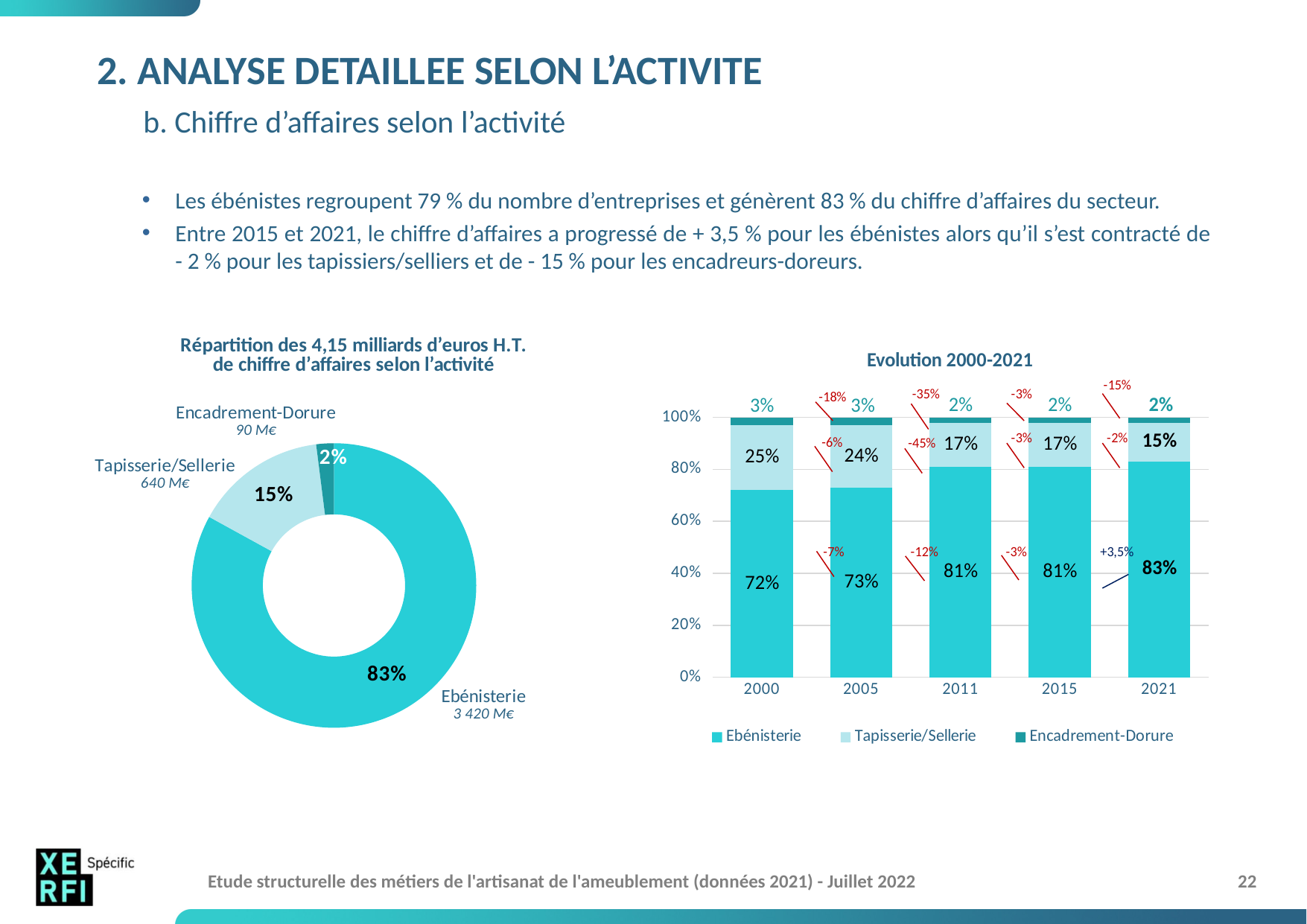
In the 'Evolution 2000-2021' chart, what is the value for Tapisserie/Sellerie in 2011? 17% How many series does the legend of the 'Evolution 2000-2021' chart list? 3 In the 'Répartition des 4,15 milliards d'euros H.T. de chiffre d'affaires selon l'activité' chart, which activity has the smallest share? Encadrement-Dorure In the 'Evolution 2000-2021' chart, does the Tapisserie/Sellerie share rise or fall from 2000 to 2021? Fall In the 'Répartition des 4,15 milliards d'euros H.T. de chiffre d'affaires selon l'activité' chart, what value in M€ is shown for Tapisserie/Sellerie? 640 M€ In the 'Répartition des 4,15 milliards d'euros H.T. de chiffre d'affaires selon l'activité' chart, how many activities are shown? 3 What kind of chart is the 'Répartition des 4,15 milliards d'euros H.T. de chiffre d'affaires selon l'activité' chart? Donut (pie) chart In the 'Répartition des 4,15 milliards d'euros H.T. de chiffre d'affaires selon l'activité' chart, what share does Ebénisterie hold? 83% In the 'Evolution 2000-2021' chart, what is the difference between the Ebénisterie share in 2021 and in 2000? 11 percentage points In the 'Evolution 2000-2021' chart, what is the value for Ebénisterie in 2000? 72% What kind of chart is the 'Evolution 2000-2021' chart? Stacked bar chart In the 'Evolution 2000-2021' chart, in which year is the Ebénisterie share highest? 2021